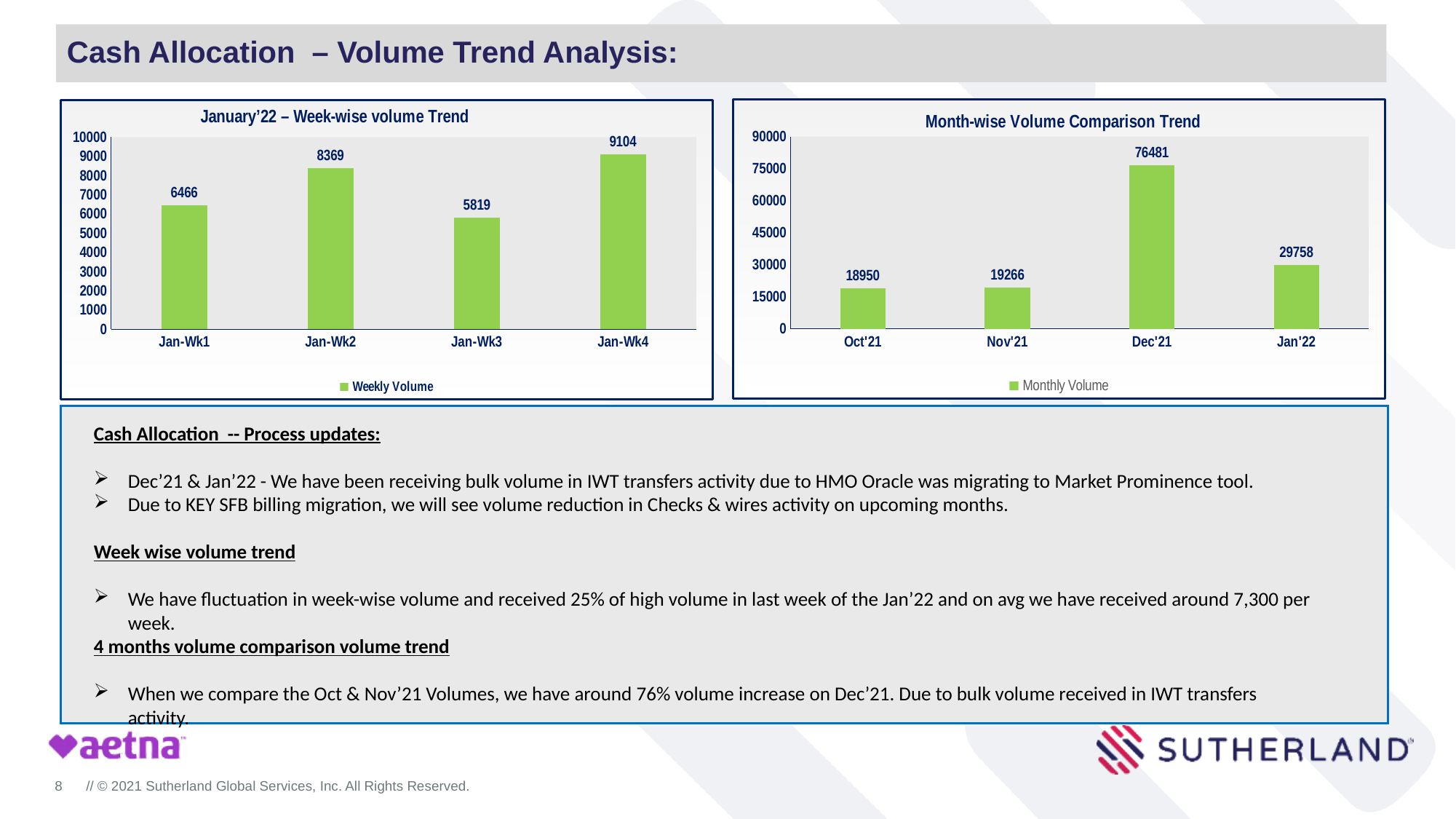
In the 'January'22 – Week-wise volume Trend' chart, which week has the highest volume? Jan-Wk4 In the 'January'22 – Week-wise volume Trend' chart, what is the value for Jan-Wk2? 8369 In the 'January'22 – Week-wise volume Trend' chart, what is the difference between Jan-Wk4 and Jan-Wk3? 3285 In the 'January'22 – Week-wise volume Trend' chart, how many weeks are plotted? 4 In the 'Month-wise Volume Comparison Trend' chart, which month has the lowest volume? Oct'21 In the 'Month-wise Volume Comparison Trend' chart, what is the difference between Nov'21 and Oct'21? 316 In the 'January'22 – Week-wise volume Trend' chart, which week has the lowest volume? Jan-Wk3 In the 'Month-wise Volume Comparison Trend' chart, what series name does the legend show? Monthly Volume In the 'Month-wise Volume Comparison Trend' chart, is the value for Jan'22 greater or less than 45000? less In the 'January'22 – Week-wise volume Trend' chart, what type of chart is shown? Bar chart In the 'Month-wise Volume Comparison Trend' chart, is the value for Jan'22 larger than the value for Nov'21? Yes In the 'Month-wise Volume Comparison Trend' chart, what is the value for Dec'21? 76481